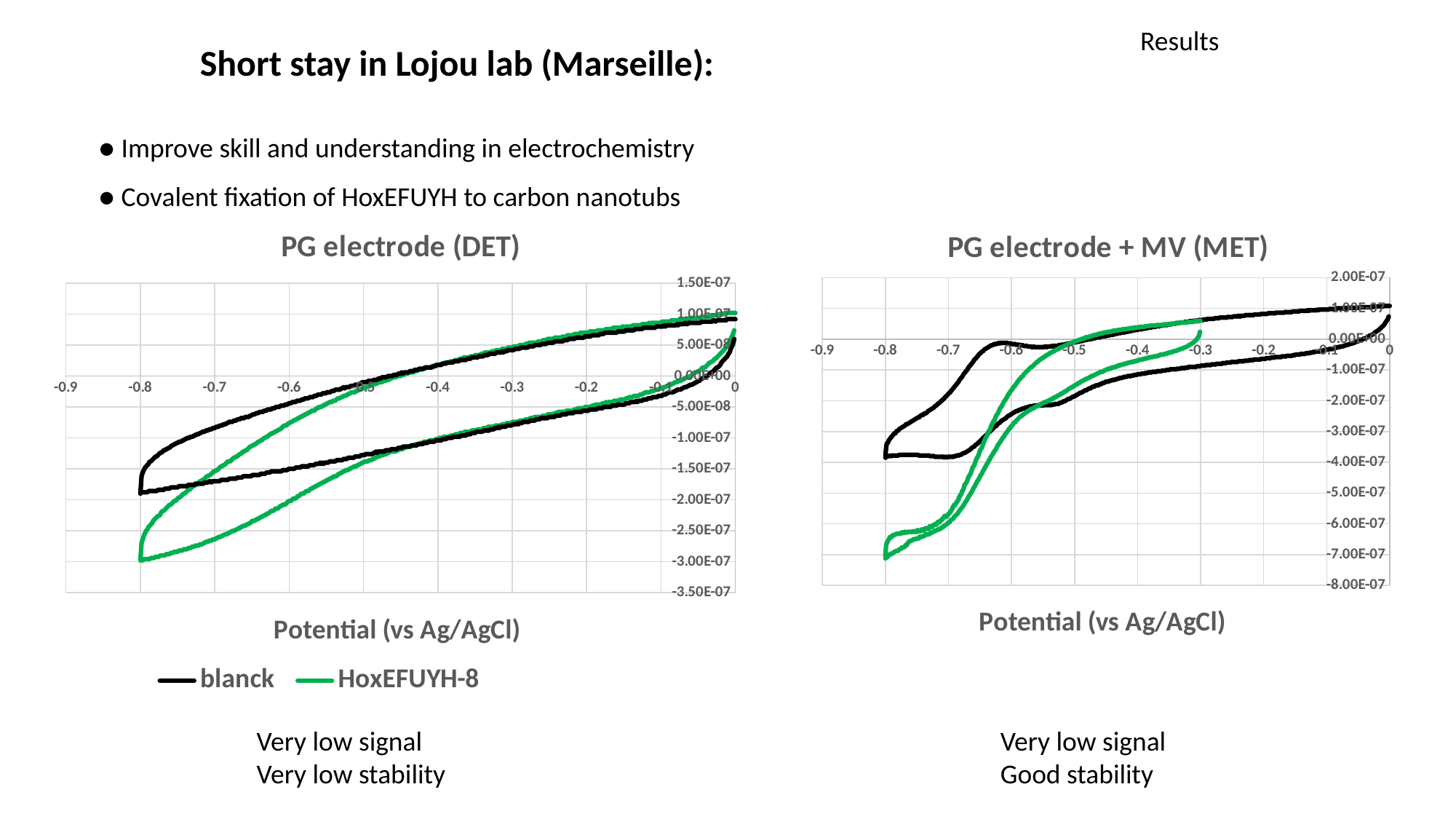
In the "PG electrode (DET)" chart, is the lowest value of the HoxEFUYH-8 curve greater or less than -2.50E-07? less In the "PG electrode + MV (MET)" chart, which series reaches the lower minimum current, blanck or HoxEFUYH-8? HoxEFUYH-8 What kind of chart is the "PG electrode (DET)" chart? line chart In the "PG electrode + MV (MET)" chart, is the lowest value of the HoxEFUYH-8 curve greater or less than -6.00E-07? less How many series does the legend list for the charts on the slide? 2 What is the x-axis label of the "PG electrode + MV (MET)" chart? Potential (vs Ag/AgCl) In the "PG electrode (DET)" chart, which series reaches the lower minimum current, blanck or HoxEFUYH-8? HoxEFUYH-8 In the "PG electrode + MV (MET)" chart, is the lowest value of the blanck curve greater or less than -3.00E-07? less How many tick labels are shown on the x axis of the "PG electrode (DET)" chart? 10 What are the two series named in the legend? blanck and HoxEFUYH-8